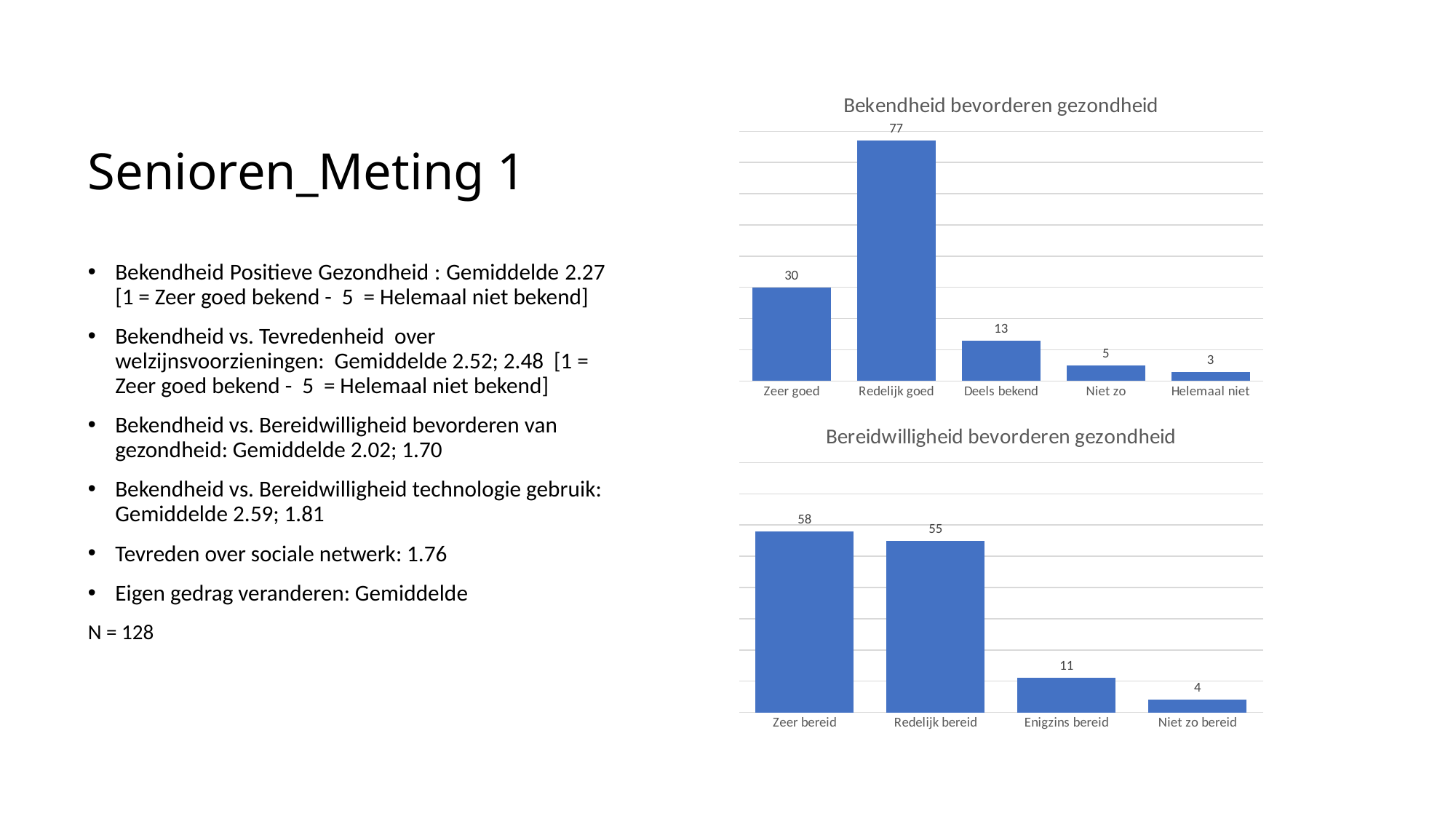
In the 'Bereidwilligheid bevorderen gezondheid' chart, which is larger: Enigzins bereid or Niet zo bereid? Enigzins bereid In the 'Bekendheid bevorderen gezondheid' chart, how many categories are shown? 5 In the 'Bereidwilligheid bevorderen gezondheid' chart, what is the value for Enigzins bereid? 11 In the 'Bereidwilligheid bevorderen gezondheid' chart, which category has the highest value? Zeer bereid What type of chart is the 'Bereidwilligheid bevorderen gezondheid' chart? Bar chart In the 'Bereidwilligheid bevorderen gezondheid' chart, how many categories are shown? 4 In the 'Bekendheid bevorderen gezondheid' chart, what is the value for Redelijk goed? 77 What is the title of the top chart on the slide? Bekendheid bevorderen gezondheid In the 'Bekendheid bevorderen gezondheid' chart, which category has the lowest value? Helemaal niet In the 'Bekendheid bevorderen gezondheid' chart, what is the value for Zeer goed? 30 In the 'Bereidwilligheid bevorderen gezondheid' chart, what is the difference between Zeer bereid and Redelijk bereid? 3 In the 'Bekendheid bevorderen gezondheid' chart, what is the difference between Redelijk goed and Zeer goed? 47